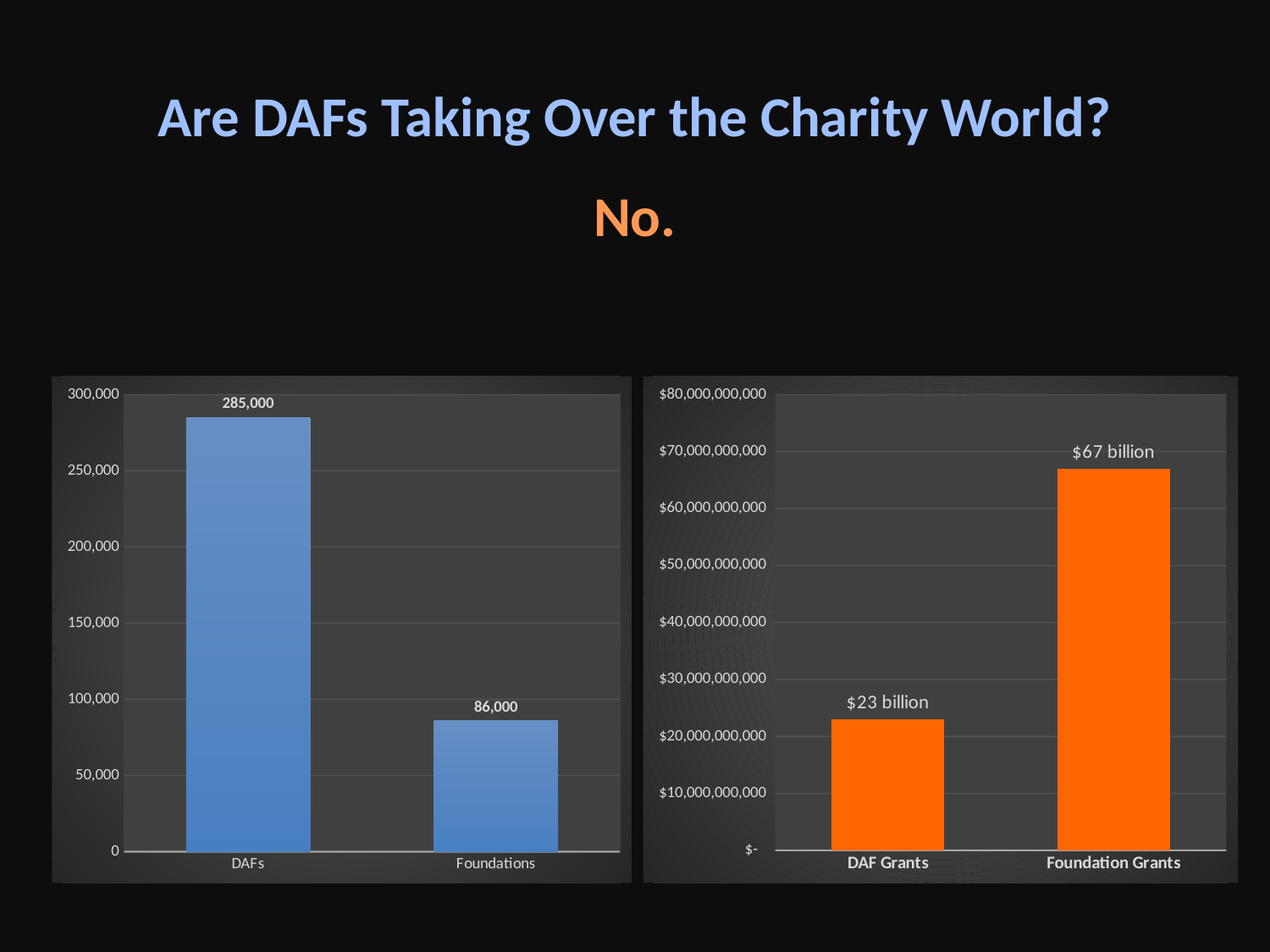
What kind of chart is the right chart? bar chart In the right chart, what is the value for Foundation Grants? $67 billion In the right chart, what is the value for DAF Grants? $23 billion In the right chart, is the value for Foundation Grants greater or less than $60,000,000,000? greater In the left chart, what is the value for Foundations? 86,000 In the right chart, which category has the lower value? DAF Grants In the left chart, which category has the higher value? DAFs What colour are the bars in the right chart? orange In the left chart, what is the difference between the DAFs and Foundations values? 199,000 In the left chart, how many categories are shown? 2 In the left chart, what is the value for DAFs? 285,000 In the right chart, what is the difference between Foundation Grants and DAF Grants? $44 billion